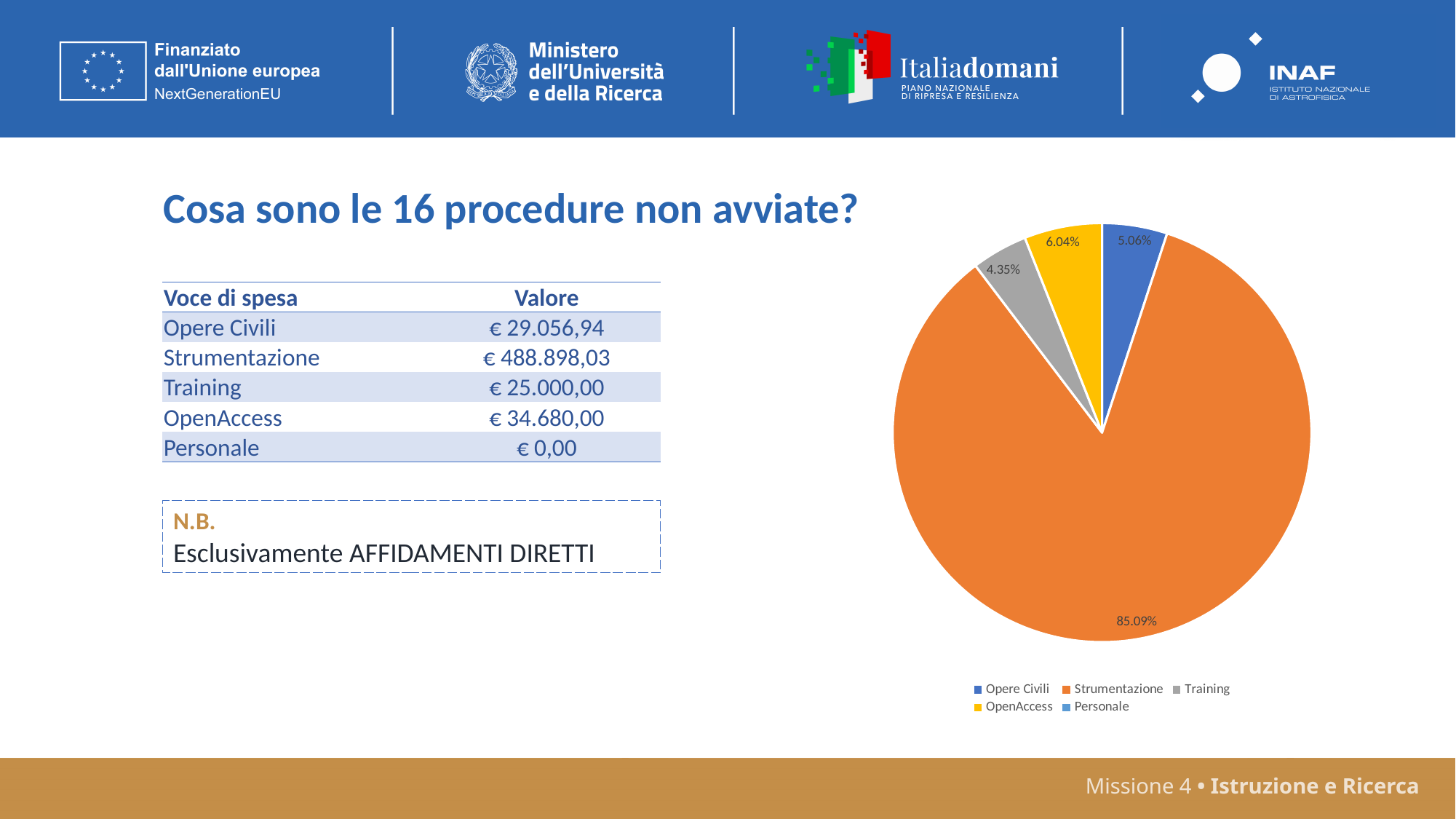
What share of the pie does Opere Civili account for? 5.06% Which slice is larger, OpenAccess or Opere Civili? OpenAccess What colour is the Strumentazione slice in the pie chart? orange Among the slices with a printed percentage, which category has the smallest slice? Training How many categories does the pie chart legend list? 5 What share of the pie does Training account for? 4.35% Which category has the largest slice of the pie? Strumentazione What is the difference in percentage points between the Strumentazione slice and the Opere Civili slice? 80.03% What is the difference in percentage points between the OpenAccess slice and the Training slice? 1.69% What kind of chart is shown on the slide? pie chart What share of the pie does OpenAccess account for? 6.04%